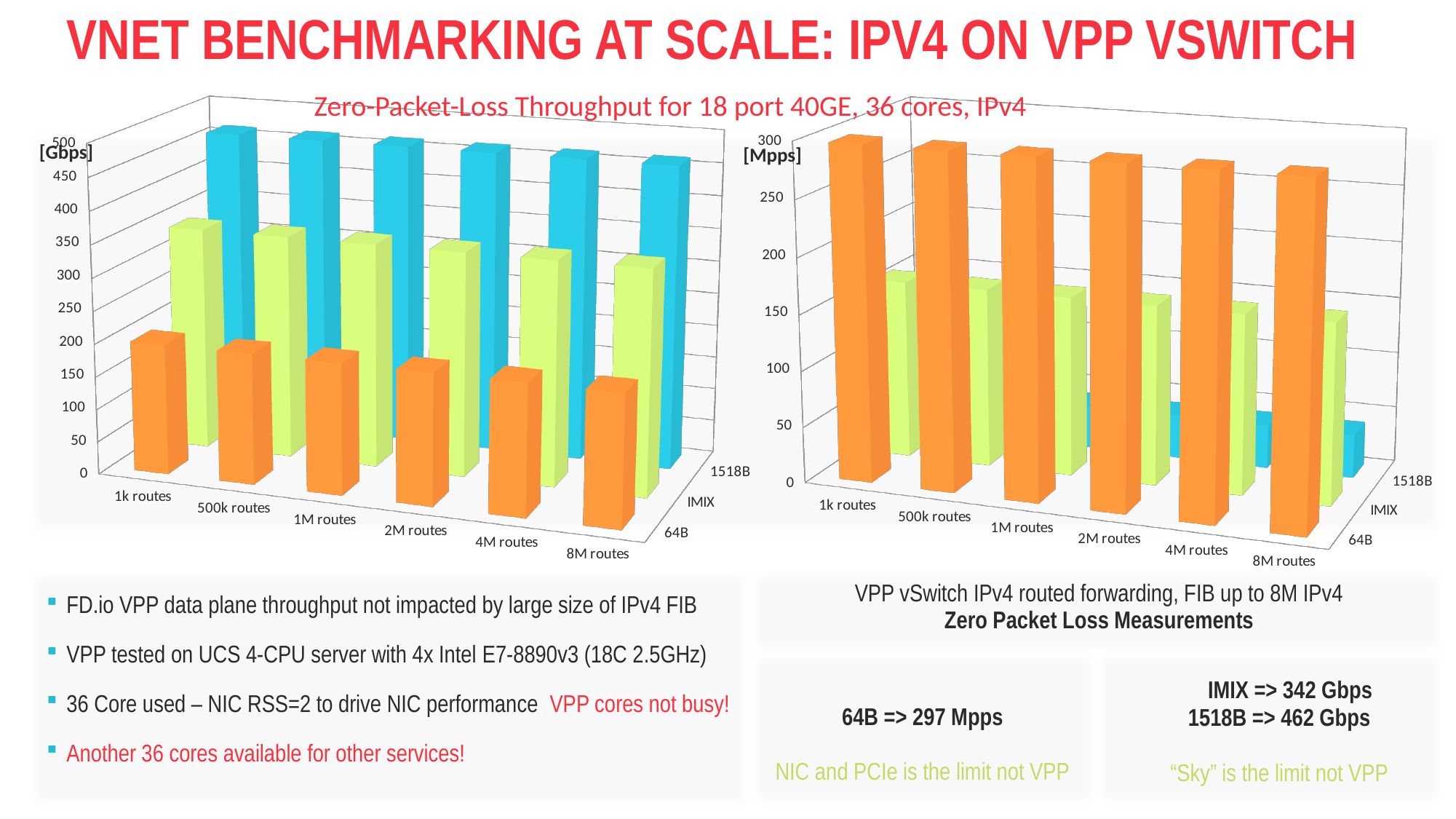
In the left [Gbps] chart, which packet-size series has the highest bars? 1518B In the right [Mpps] chart, which packet-size series has the highest bars? 64B In the left [Gbps] chart, is the 1518B value for 1k routes greater or less than 400? greater In the right [Mpps] chart, is the 1518B value for 1k routes greater or less than 100? less In the right [Mpps] chart, which packet-size series has the lowest bars? 1518B What kind of chart is the left chart labelled [Gbps]? bar chart In the right [Mpps] chart, is the 64B value for 1k routes greater or less than 250? greater In the left [Gbps] chart, at 8M routes, which is larger: the 1518B value or the 64B value? 1518B How many route-count categories are shown along the x axis of the left [Gbps] chart? 6 How many packet-size series does the right [Mpps] chart show? 3